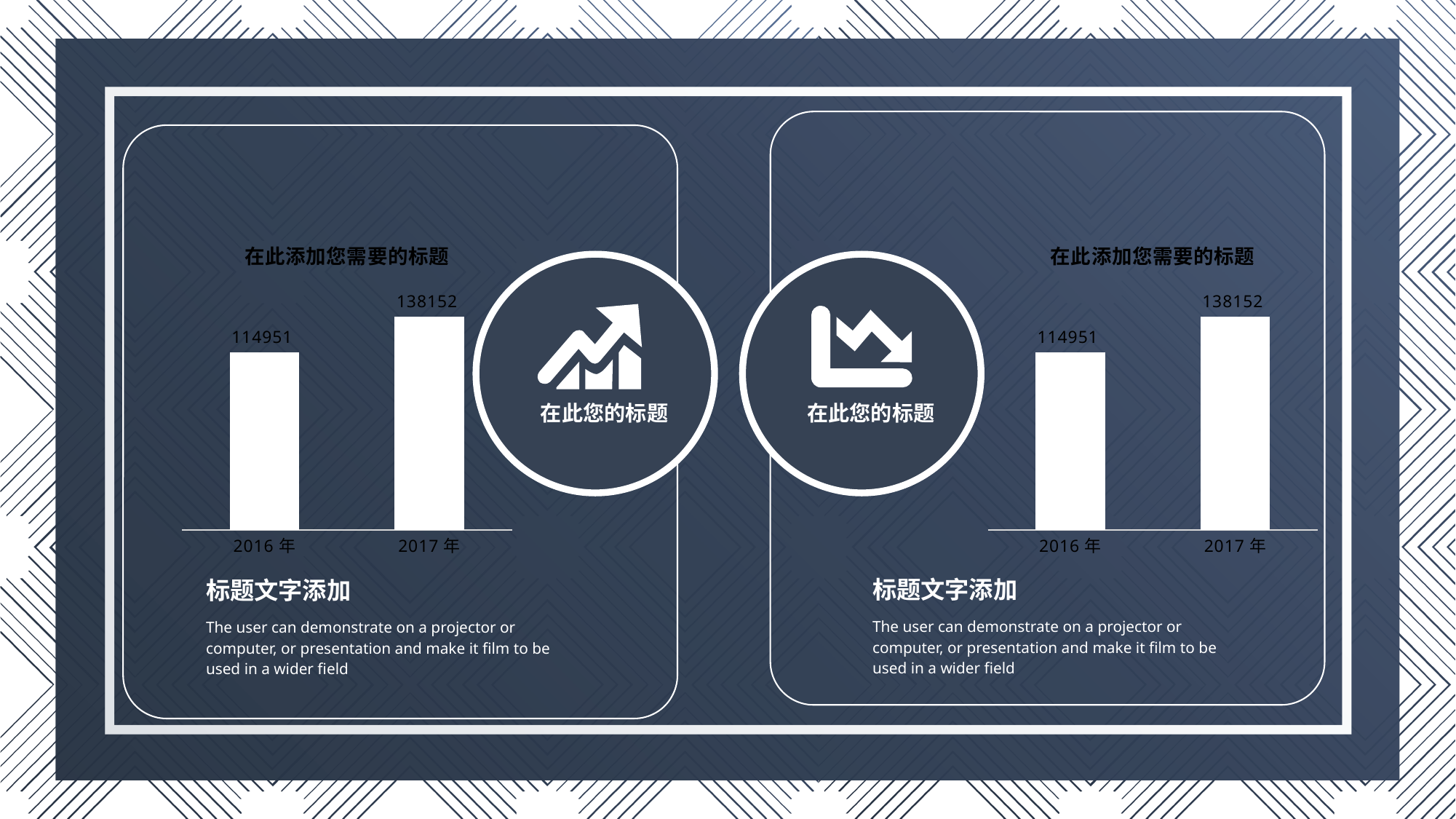
How many categories are shown in the left chart? 2 In the left chart, what is the value for 2017 年? 138152 In the left chart, which category has the highest value? 2017 年 In the left chart, what is the value for 2016 年? 114951 What kind of chart is the right chart? bar chart In the right chart, what is the value for 2017 年? 138152 In the right chart, which is larger, the value for 2016 年 or 2017 年? 2017 年 In the left chart, do the values rise or fall from 2016 年 to 2017 年? rise In the left chart, what is the difference between the 2017 年 and 2016 年 values? 23201 How many charts are on the slide? 2 In the right chart, which category has the lowest value? 2016 年 In the right chart, what is the value for 2016 年? 114951